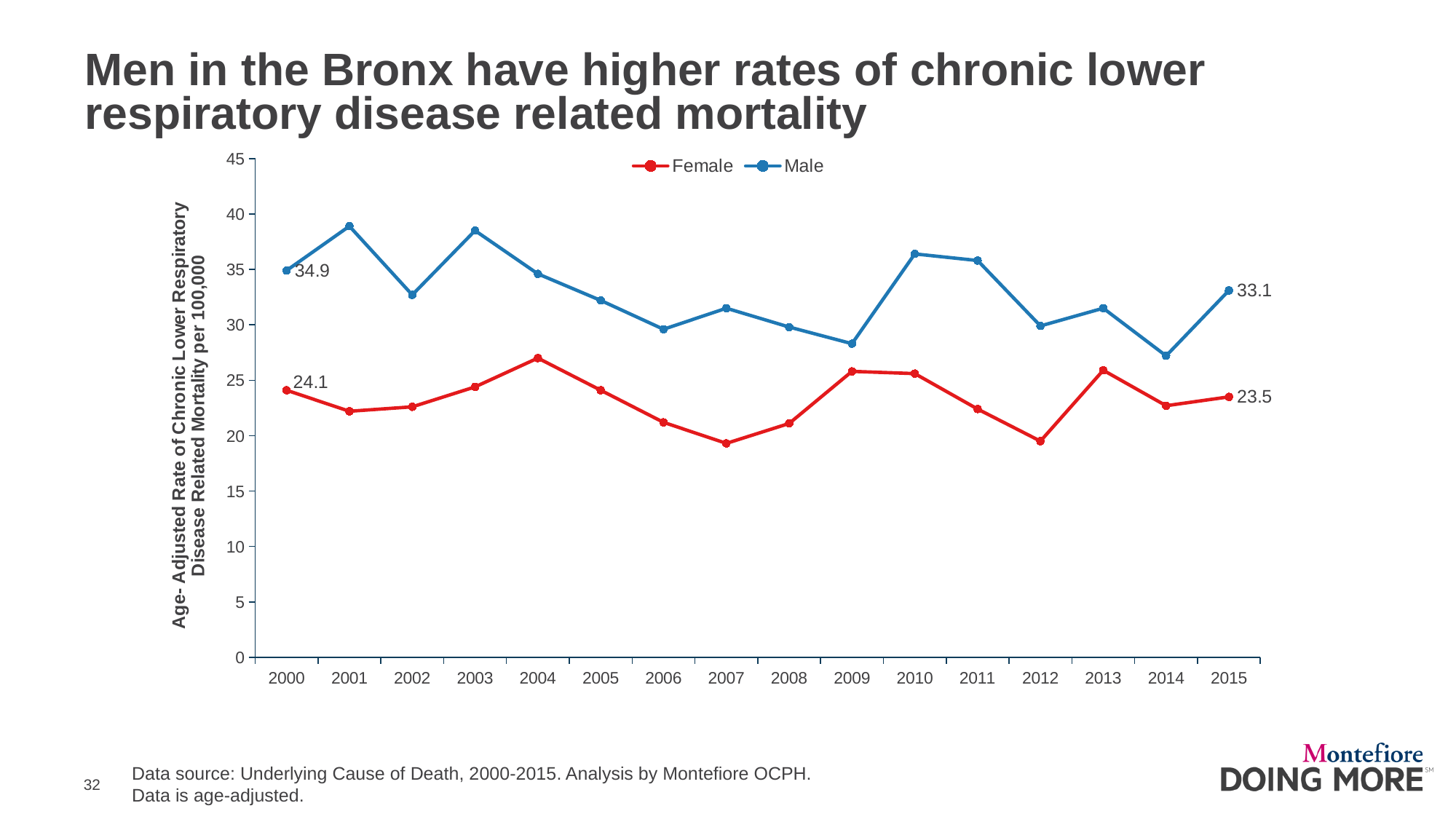
What is the difference between the Male and Female values in 2015? 9.6 What kind of chart is shown on the slide? line chart What is the Female value in 2015? 23.5 What is the difference between the Male and Female values in 2000? 10.8 How many series does the legend list? 2 How many years are shown on the x axis? 16 What is the Male value in 2015? 33.1 What is the Female value in 2000? 24.1 Is the Female value for 2007 greater or less than 20? less What is the Male value in 2000? 34.9 Is the Male value for 2001 greater or less than 35? greater Which series has the higher value in 2015, Male or Female? Male